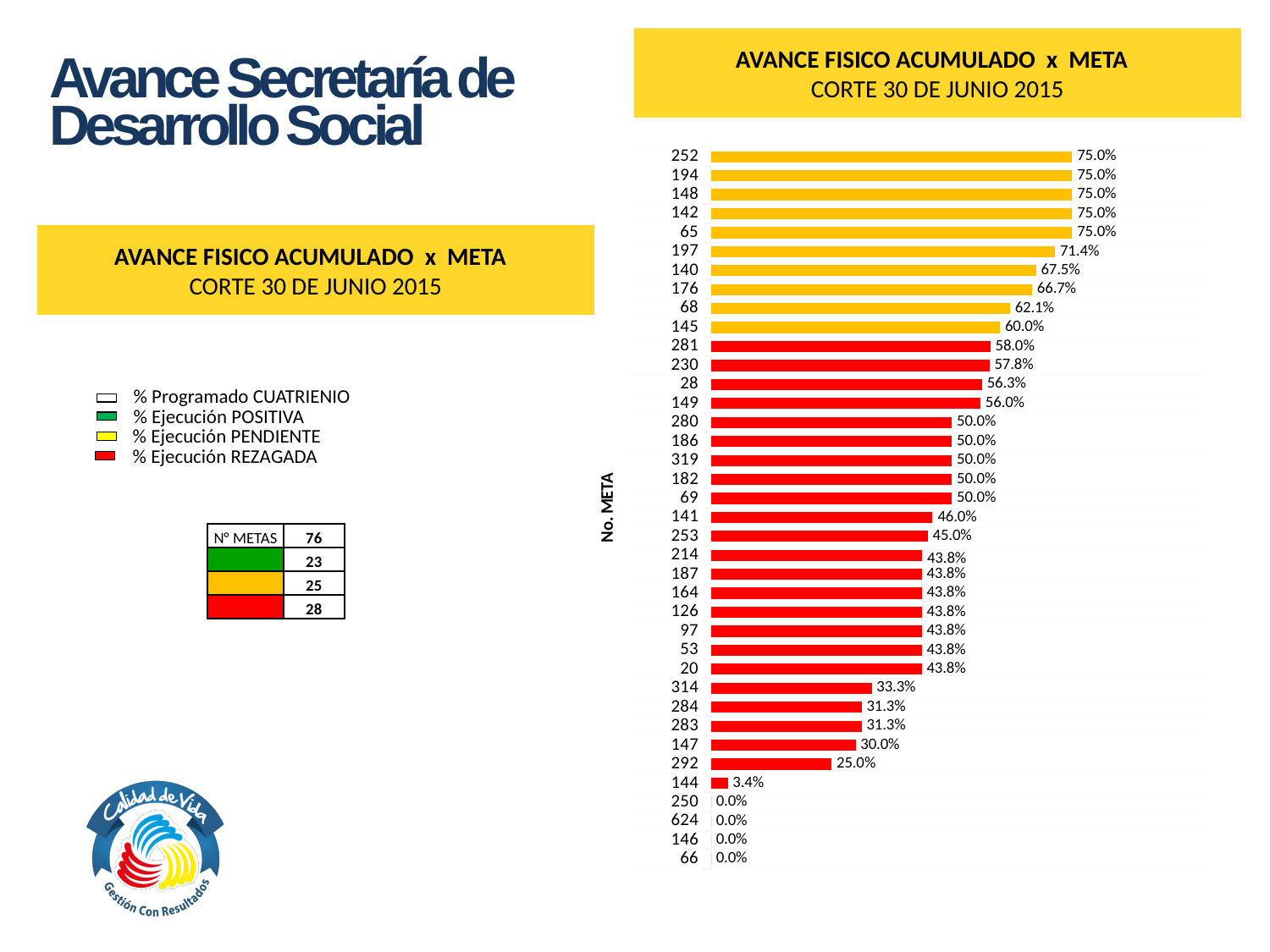
What is the value for meta 144? 3.4% What is the value for meta 292? 25.0% How many metas have a value of 0.0%? 4 How many metas (categories) are plotted in the chart? 38 Which has a larger value, meta 140 or meta 176? 140 What is the difference between the values for meta 252 and meta 145? 15.0% What is the value for meta 68? 62.1% What is the value for meta 197? 71.4% What is the value for meta 314? 33.3% What type of chart is shown on the slide? bar chart What is the title of the chart? AVANCE FISICO ACUMULADO x META CORTE 30 DE JUNIO 2015 Do the values rise or fall going from the top of the chart to the bottom? fall